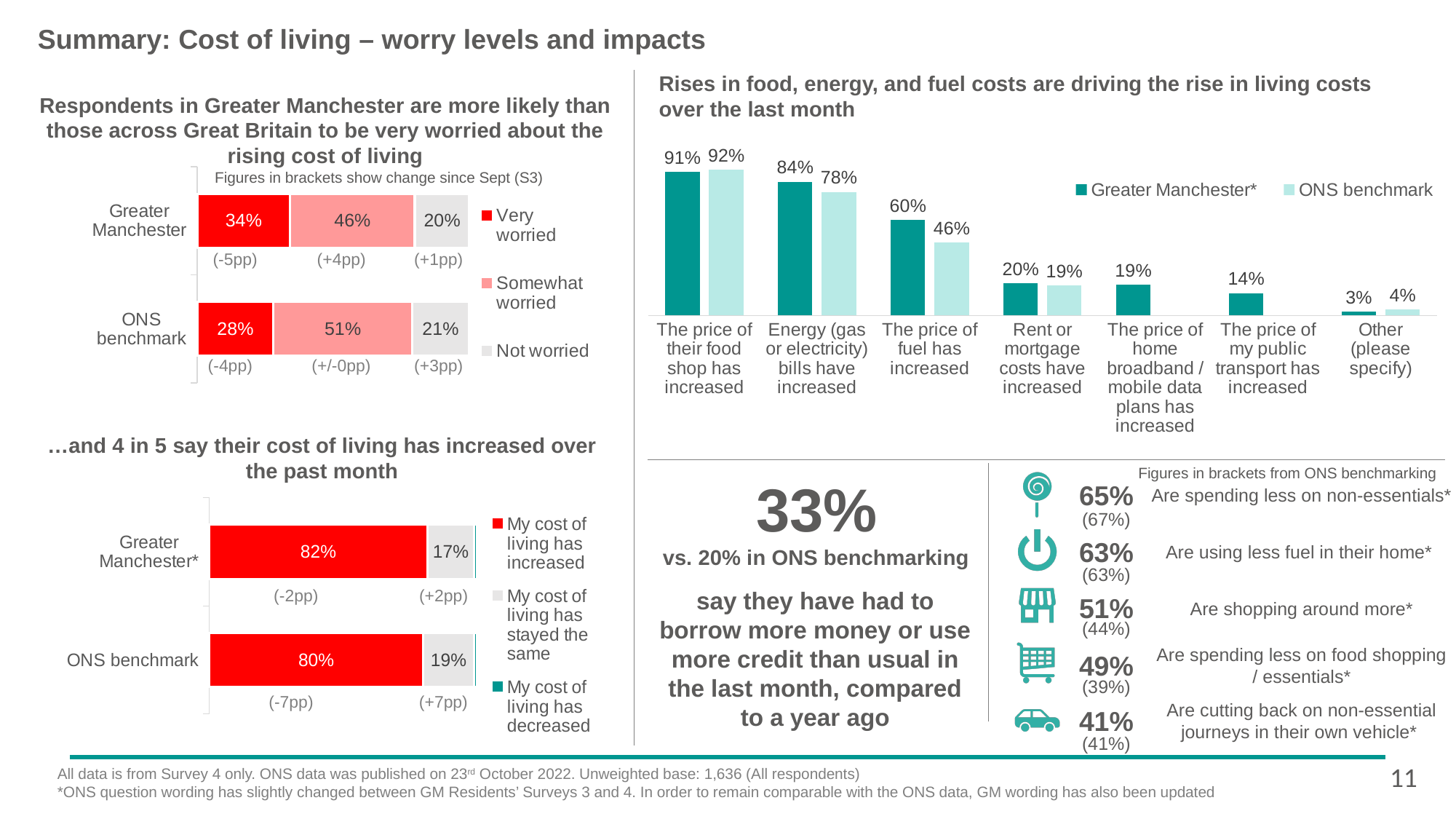
In the top-left chart on worry levels, what percentage of Greater Manchester respondents are very worried? 34% In the top-right chart on rises in living costs, how many categories are shown on the x axis? 7 In the top-left chart on worry levels, how many series does the legend list? 3 In the top-right chart on rises in living costs, what is the Greater Manchester value for 'The price of fuel has increased'? 60% In the bottom-left chart on cost of living over the past month, which has the larger share saying their cost of living has increased: Greater Manchester or the ONS benchmark? Greater Manchester In the top-left chart on worry levels, how many percentage points higher is the very worried share for Greater Manchester than for the ONS benchmark? 6 percentage points In the top-right chart on rises in living costs, which category has the highest ONS benchmark value? The price of their food shop has increased In the bottom-left chart on cost of living over the past month, what percentage of the ONS benchmark say their cost of living has increased? 80% In the top-left chart on worry levels, what percentage of the ONS benchmark is somewhat worried? 51% In the top-right chart on rises in living costs, what is the difference between the Greater Manchester and ONS benchmark values for 'The price of fuel has increased'? 14 percentage points In the top-right chart on rises in living costs, do the Greater Manchester values rise or fall from left to right across the categories? Fall What type of chart is the top-right chart on rises in food, energy and fuel costs? Bar chart